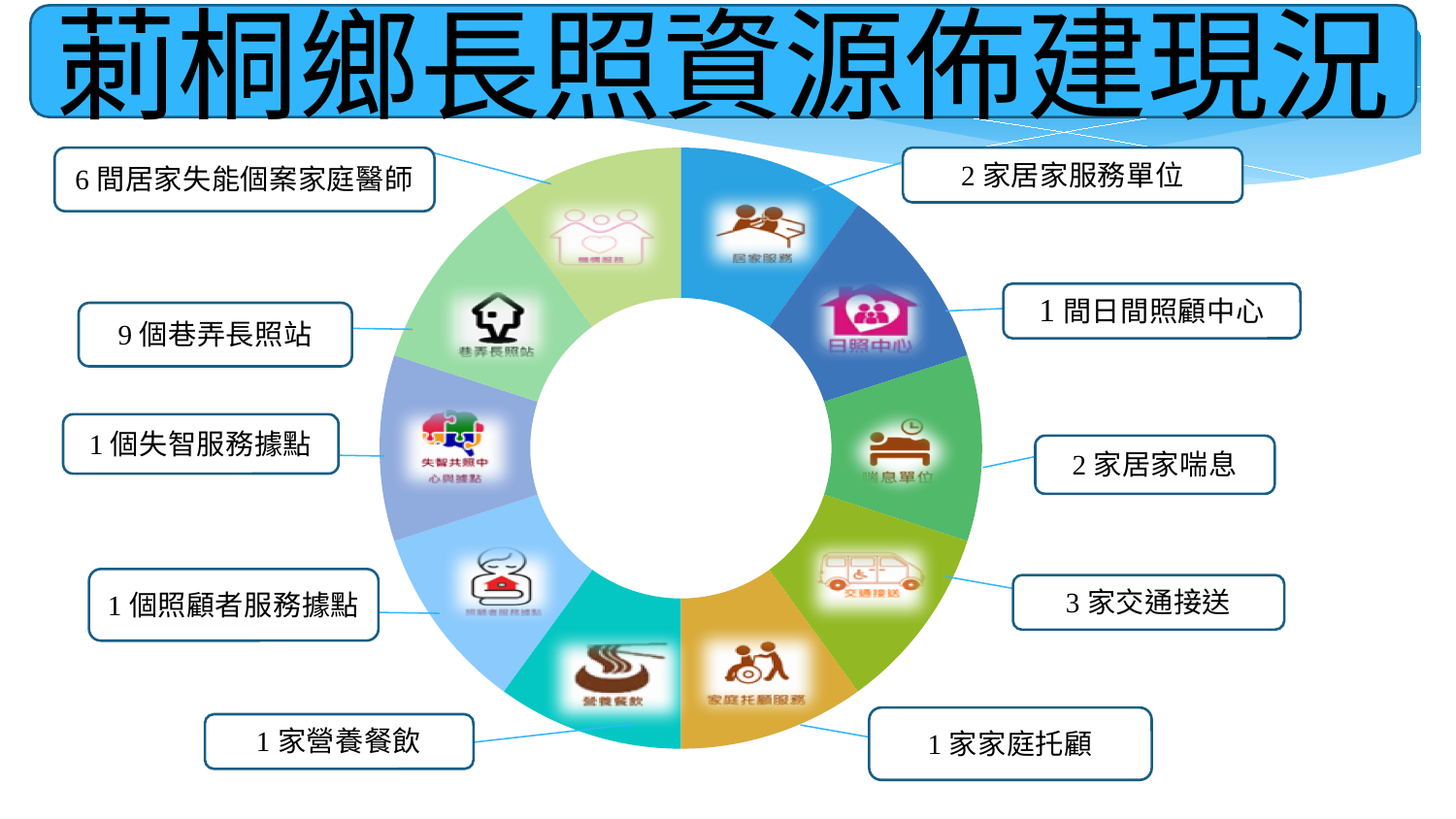
Which has a higher count, 居家喘息 or 交通接送? 交通接送 How many segments does the ring diagram have? 10 What is the difference between the number of 巷弄長照站 and the number of 居家失能個案家庭醫師? 3 Which resource type has the highest count on the slide? 巷弄長照站 How many 居家失能個案家庭醫師 are listed on the slide? 6 間 How many 居家服務單位 are listed on the slide? 2 家 How many 日間照顧中心 are listed on the slide? 1 間 What kind of chart is shown on the slide? donut chart How many 巷弄長照站 are listed on the slide? 9 個 What is the title of the slide's ring diagram? 莿桐鄉長照資源佈建現況 How many 交通接送 providers are listed on the slide? 3 家 How many resource types on the slide have a count of 1? 5